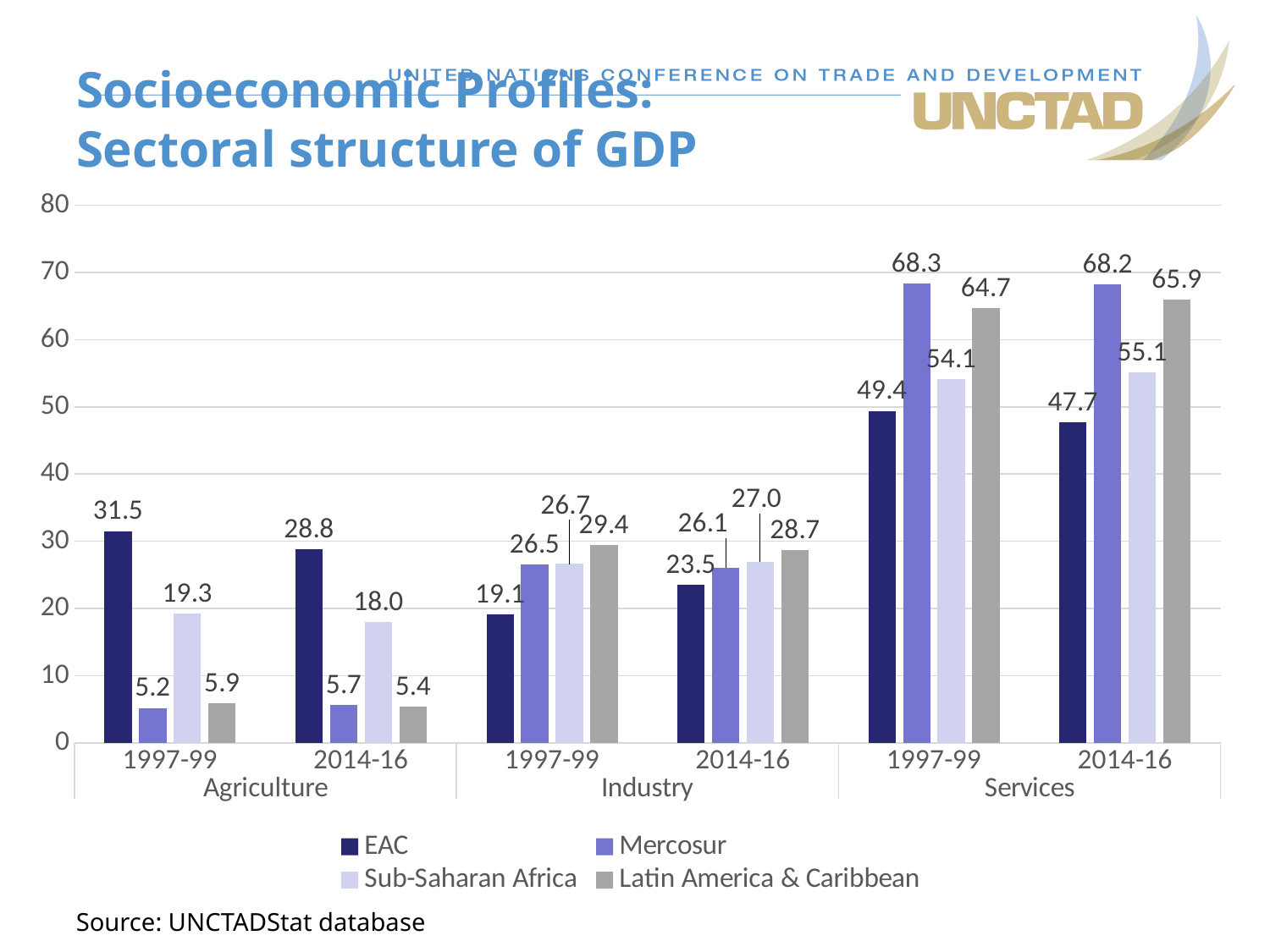
Which series has the highest value in Services for 1997-99? Mercosur How many series does the legend list? 4 Does the EAC value in Services fall or rise from 1997-99 to 2014-16? Fall What is the value for Latin America & Caribbean in Agriculture for 2014-16? 5.4 Which is larger: the Sub-Saharan Africa value in Services for 2014-16 or the Latin America & Caribbean value in Services for 2014-16? Latin America & Caribbean Which series has the lowest value in Agriculture for 1997-99? Mercosur What kind of chart is shown on the slide? Bar chart What is the value for Mercosur in Services for 2014-16? 68.2 What is the value for Sub-Saharan Africa in Industry for 2014-16? 27.0 What is the source cited below the chart? UNCTADStat database What is the value for EAC in Agriculture for 1997-99? 31.5 What is the difference between the EAC values for Agriculture in 1997-99 and 2014-16? 2.7